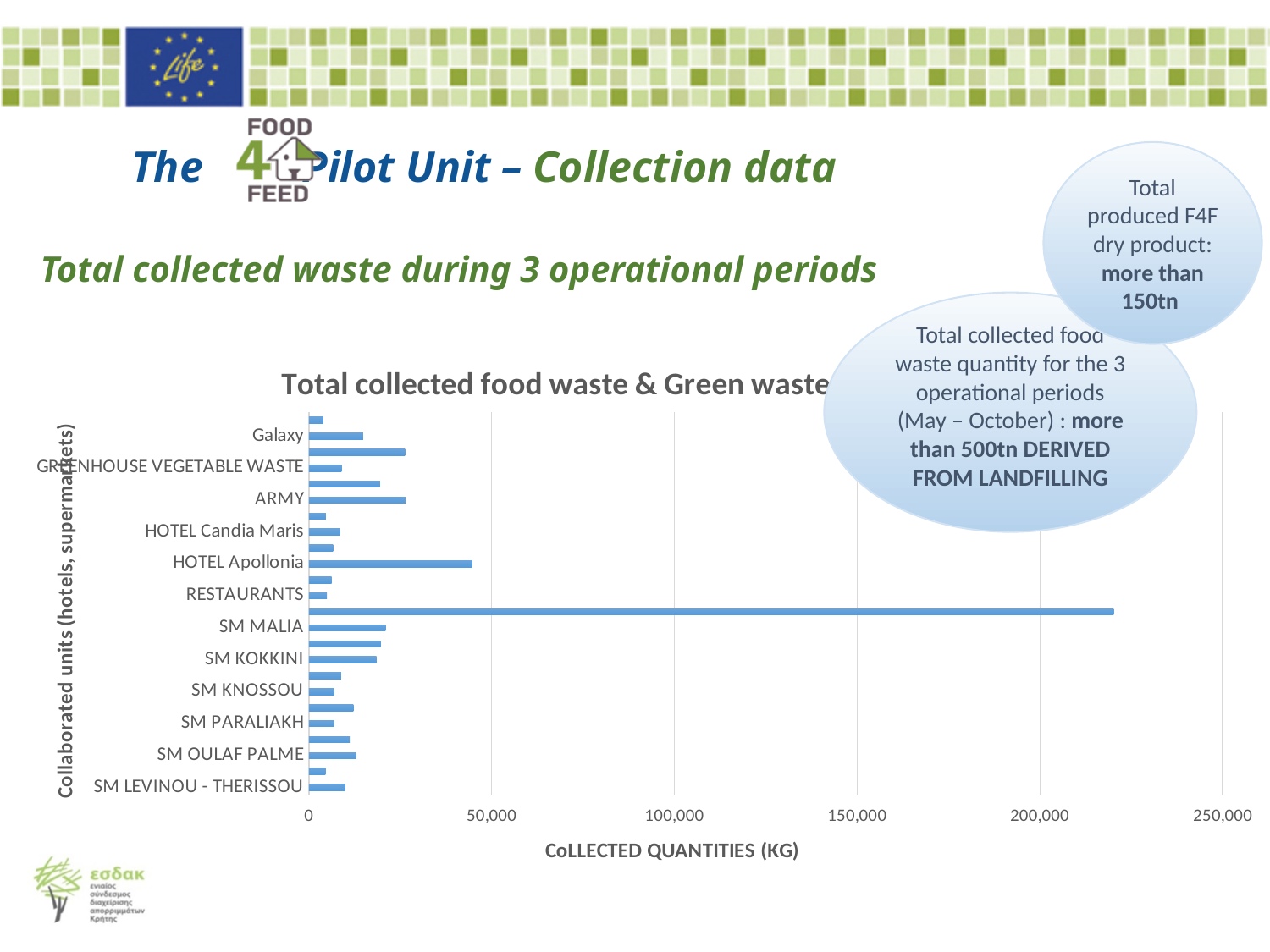
Is the value for ARMY greater or less than 50,000? less Is the value for RESTAURANTS greater or less than 50,000? less What is the highest value shown on the horizontal axis of the chart? 250,000 Which has the larger value, HOTEL Apollonia or RESTAURANTS? HOTEL Apollonia What is the title of the chart? Total collected food waste & Green waste What is the label of the horizontal axis of the chart? CoLLECTED QUANTITIES (KG) Which has the larger value, ARMY or Galaxy? ARMY Is the value for HOTEL Apollonia greater or less than 50,000? less What kind of chart is shown on the slide? bar chart How many category labels are shown on the vertical axis of the chart? 12 Which has the larger value, SM MALIA or SM PARALIAKH? SM MALIA